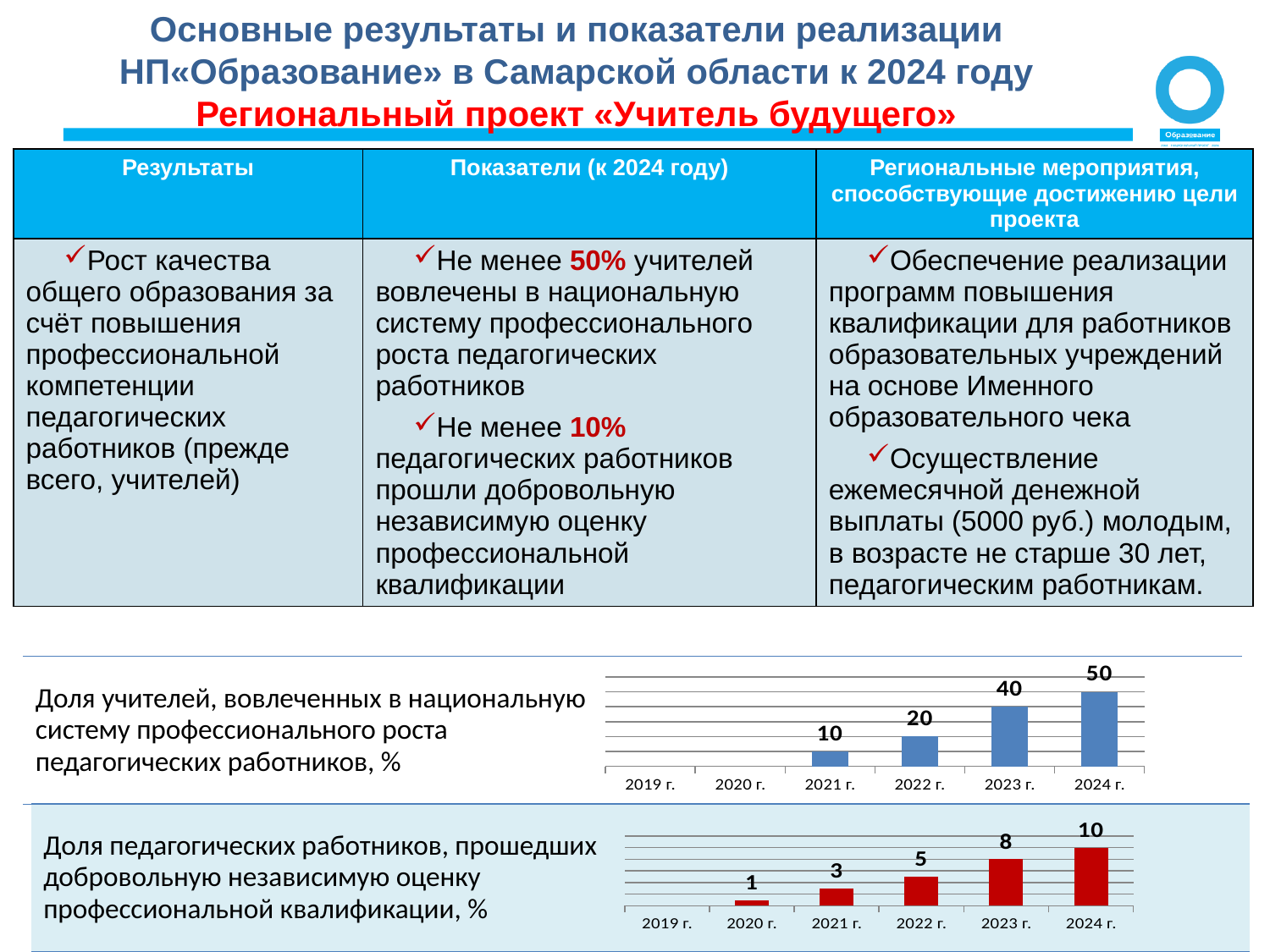
In the bottom chart (share of teaching staff who passed voluntary independent qualification assessment), what is the value for 2023 г.? 8 In the bottom chart (share of teaching staff who passed voluntary independent qualification assessment), which year with a labelled bar has the lowest value? 2020 г. In the top chart (share of teachers involved in the national system of professional growth), what is the value for 2024 г.? 50 In the top chart (share of teachers involved in the national system of professional growth), what is the difference between the values for 2023 г. and 2021 г.? 30 In the bottom chart (share of teaching staff who passed voluntary independent qualification assessment), which is larger: the value for 2022 г. or the value for 2023 г.? 2023 г. In the top chart (share of teachers involved in the national system of professional growth), what is the value for 2022 г.? 20 In the bottom chart (share of teaching staff who passed voluntary independent qualification assessment), what is the value for 2021 г.? 3 What type of chart is the bottom chart (share of teaching staff who passed voluntary independent qualification assessment)? bar chart In the top chart (share of teachers involved in the national system of professional growth), do the values rise or fall from 2021 г. to 2024 г.? rise In the top chart (share of teachers involved in the national system of professional growth), which year has the highest value? 2024 г. In the bottom chart (share of teaching staff who passed voluntary independent qualification assessment), what is the difference between the values for 2024 г. and 2022 г.? 5 In the top chart (share of teachers involved in the national system of professional growth), how many year categories are shown on the x axis? 6